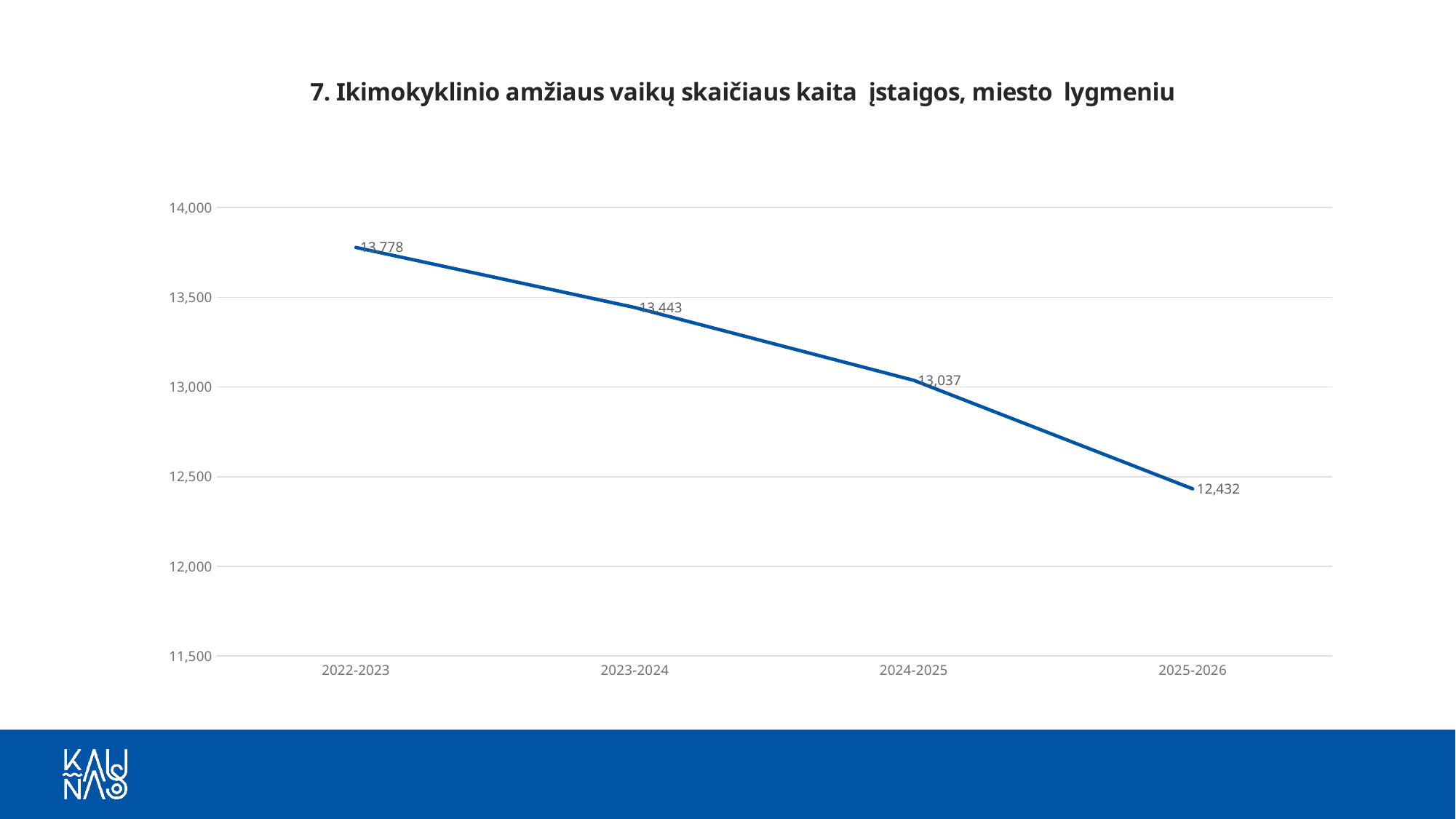
Which is larger, the value for 2023-2024 or the value for 2024-2025? 2023-2024 What is the value for 2022-2023? 13,778 How many periods are plotted on the chart? 4 Is the value for 2025-2026 greater or less than 12,500? less What is the difference between the values for 2022-2023 and 2025-2026? 1,346 What kind of chart is shown on the slide? line chart Which period has the lowest value? 2025-2026 What is the value for 2025-2026? 12,432 What is the difference between the values for 2023-2024 and 2024-2025? 406 Which period has the highest value? 2022-2023 What is the value for 2024-2025? 13,037 What is the value for 2023-2024? 13,443